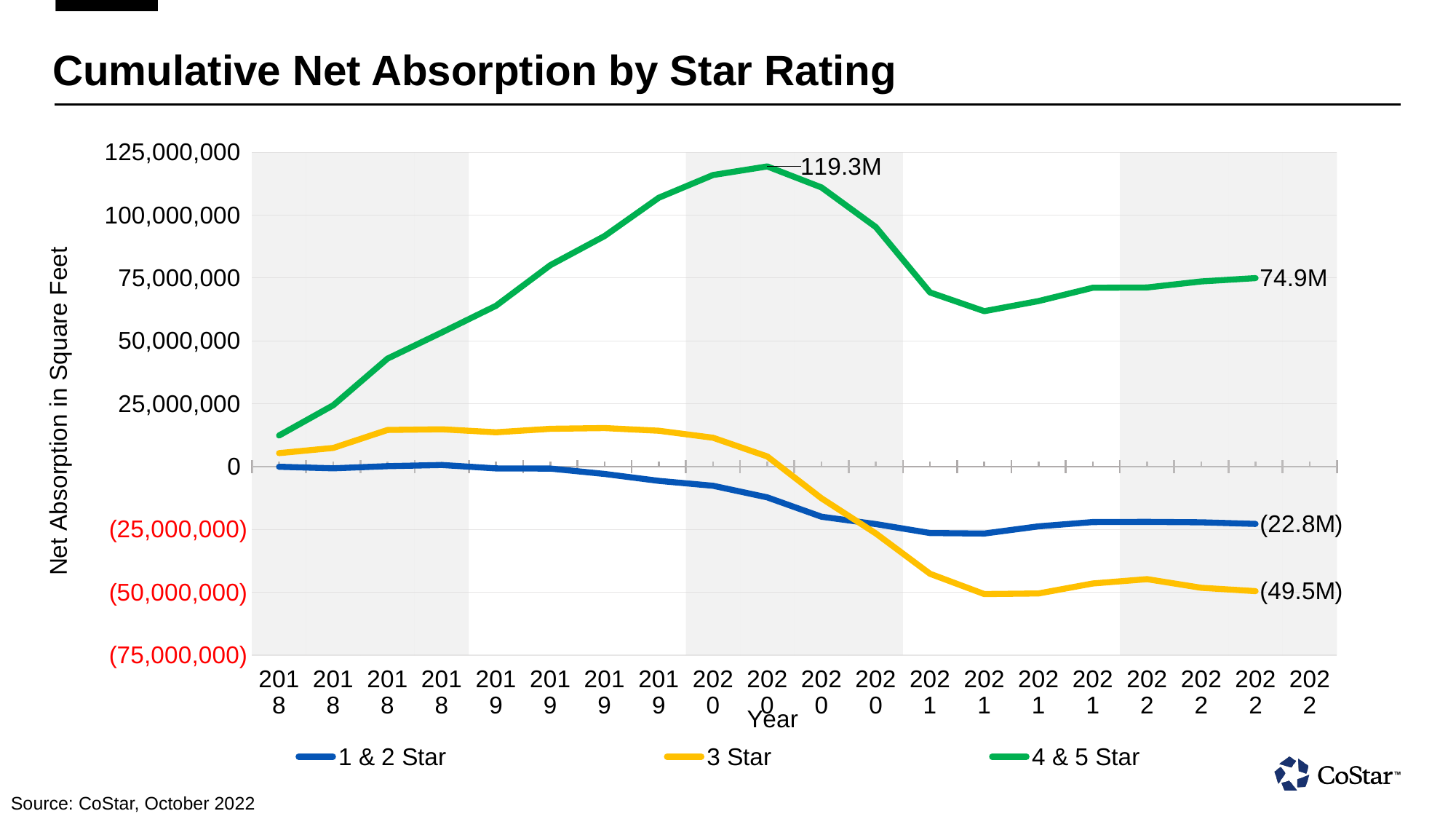
How many series does the legend list? 3 Does the 4 & 5 Star line rise or fall from the start of 2018 to its 2020 peak? rise What is the final labelled value of the 3 Star line in 2022? (49.5M) Which series has the highest value at the end of the chart? 4 & 5 Star What kind of chart is shown on the slide? line chart What is the final labelled value of the 1 & 2 Star line in 2022? (22.8M) Is the value for 4 & 5 Star at the first 2018 point greater or less than 25,000,000? less What is the difference between the 4 & 5 Star peak of 119.3M and its final value of 74.9M? 44.4M What is the final labelled value of the 4 & 5 Star line in 2022? 74.9M What is the peak value labelled on the 4 & 5 Star line? 119.3M What is the title of the y axis? Net Absorption in Square Feet Which series has the lowest value at the end of the chart? 3 Star